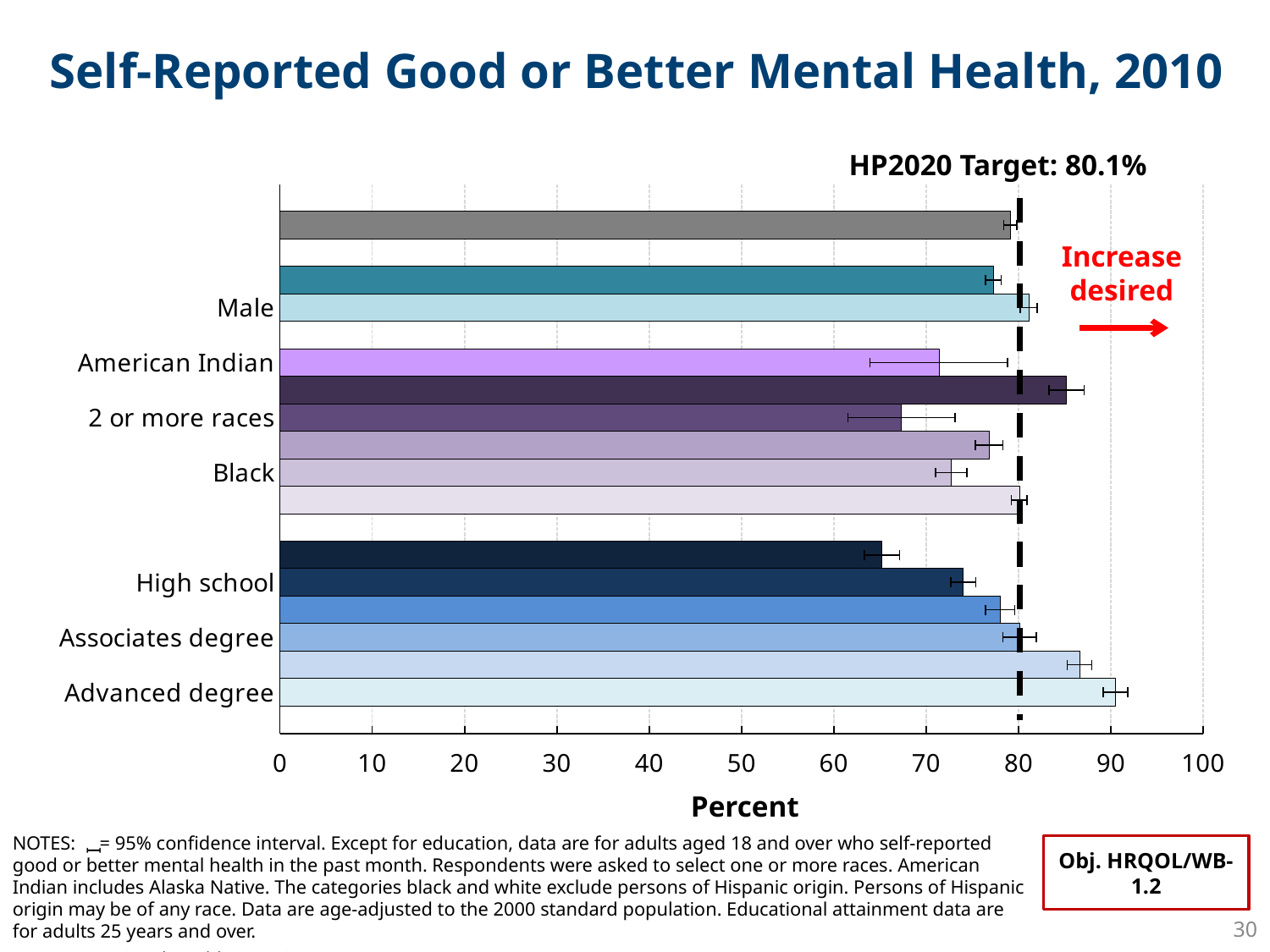
Which has the larger value, American Indian or 2 or more races? American Indian Is the value for Advanced degree greater or less than 80? greater Is the value for Male greater or less than 70? greater What kind of chart is shown on the slide? bar chart Is the value for American Indian greater or less than 80? less Which has the larger value, Advanced degree or High school? Advanced degree Among the labeled categories, which has the highest value? Advanced degree What is the HP2020 Target value shown on the chart? 80.1% What is the title of the x axis? Percent